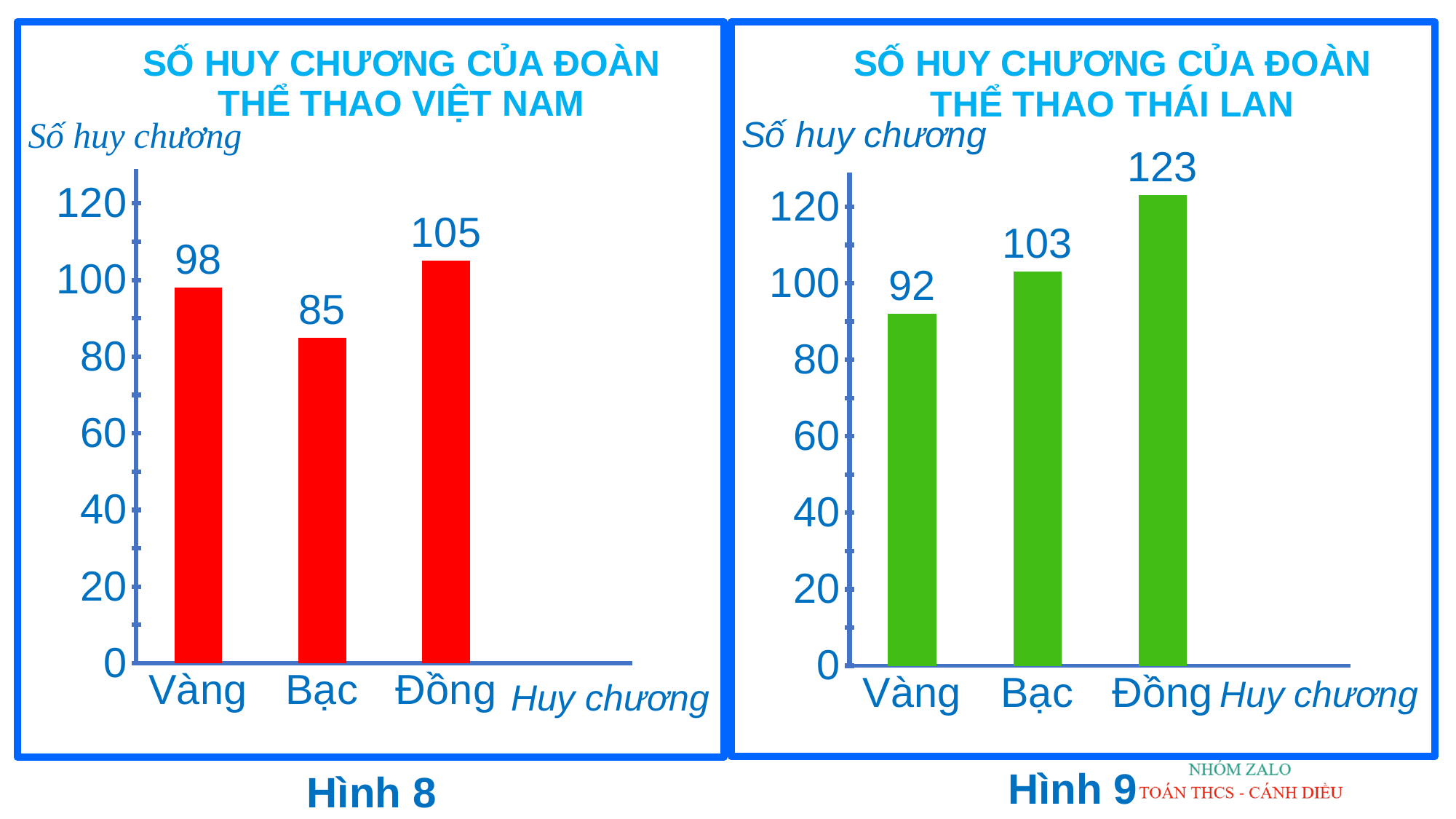
In the Vietnam chart (Hình 8, left), which medal type has the highest count? Đồng In the Vietnam chart (Hình 8, left), how many medals are shown for Bạc? 85 In the Thailand chart (Hình 9, right), which is larger, the Bạc count or the Vàng count? Bạc What type of chart is the Thailand chart (Hình 9, right)? Bar chart In the Vietnam chart (Hình 8, left), what is the difference between the Đồng and Bạc counts? 20 What colour are the bars in the Vietnam chart (Hình 8, left)? Red In the Thailand chart (Hình 9, right), what is the difference between the Đồng and Vàng counts? 31 In the Thailand chart (Hình 9, right), which medal type has the lowest count? Vàng In the Thailand chart (Hình 9, right), how many medals are shown for Vàng? 92 How many categories are shown on the x axis of the Vietnam chart (Hình 8, left)? 3 In the Vietnam chart (Hình 8, left), how many medals are shown for Vàng? 98 In the Thailand chart (Hình 9, right), how many medals are shown for Đồng? 123